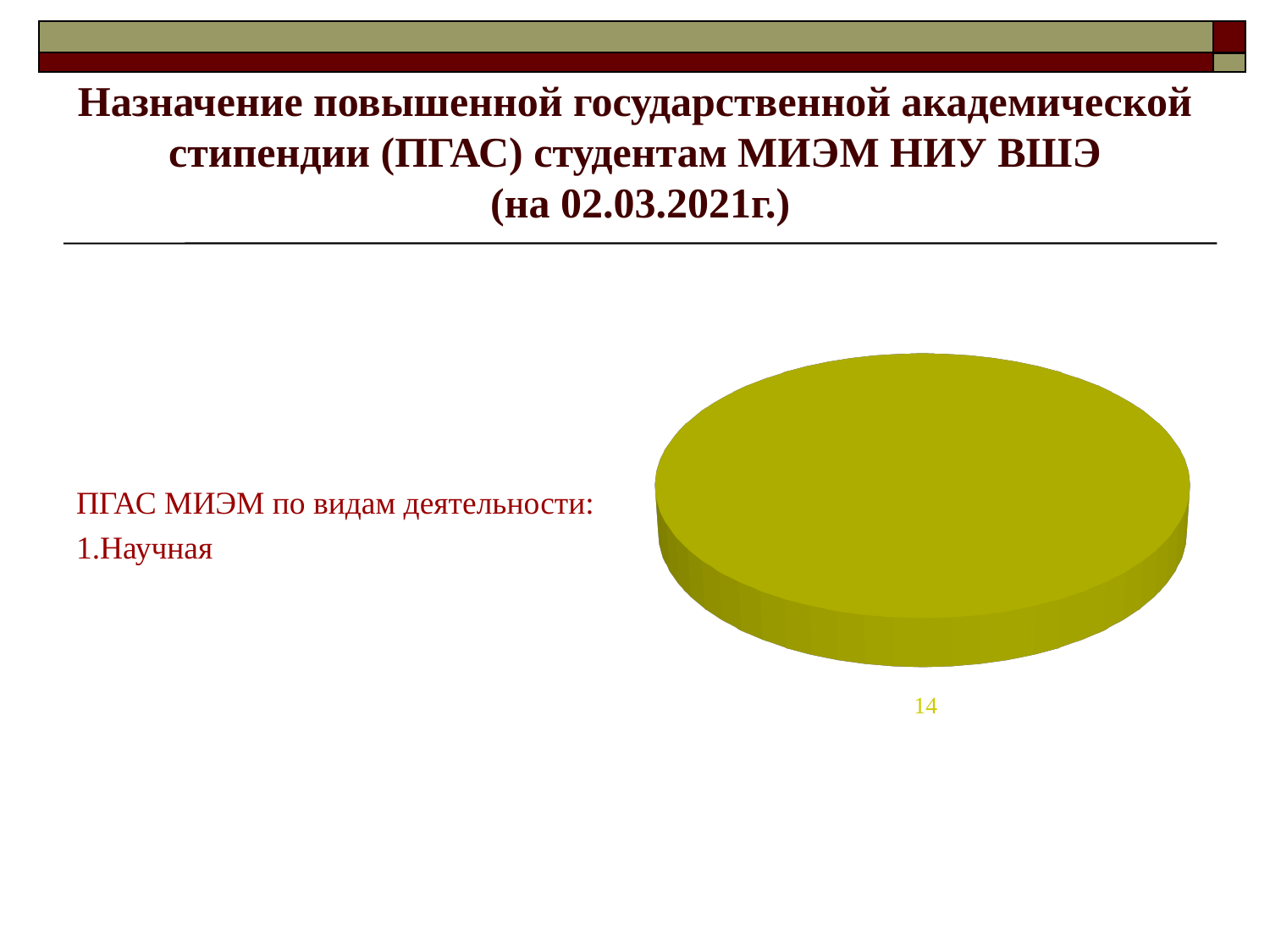
What share of the pie does the single slice represent? 100% What colour is the slice of the pie chart? yellow-green (olive) Which type of activity does the text next to the pie chart list as item 1? Научная Is the value shown on the pie chart greater or less than 10? greater What value is printed as the data label on the pie chart? 14 How many slices does the pie chart have? 1 What kind of chart is shown on the slide? pie chart